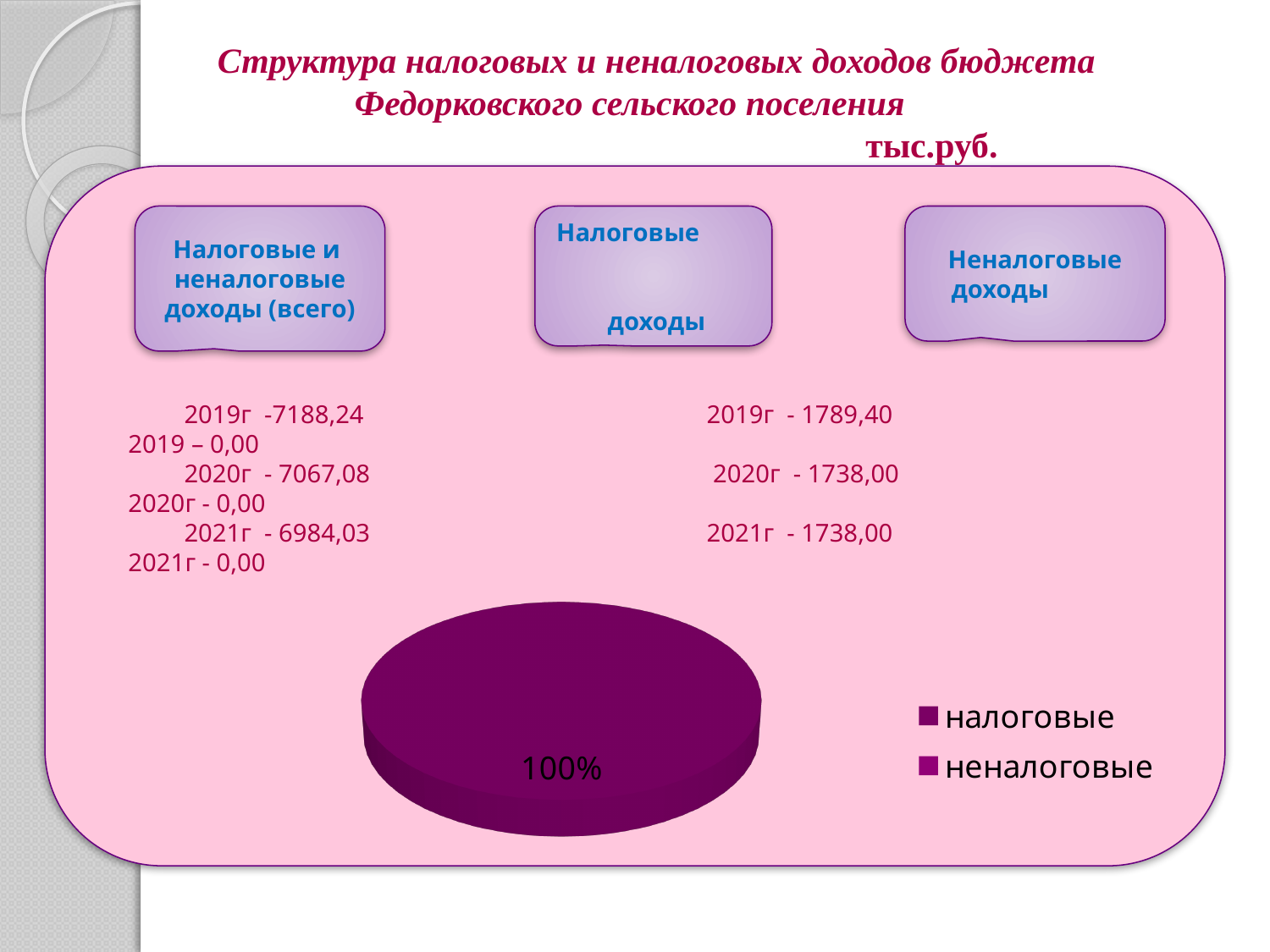
What percentage is printed on the pie chart's slice? 100% What are the two entries in the pie chart's legend? налоговые, неналоговые How many slices are visible in the pie chart? 1 How many entries does the pie chart's legend list? 2 What kind of chart is shown on the slide? pie chart Which legend category accounts for the 100% slice of the pie chart? налоговые What unit of measurement is stated above the chart area? тыс.руб.